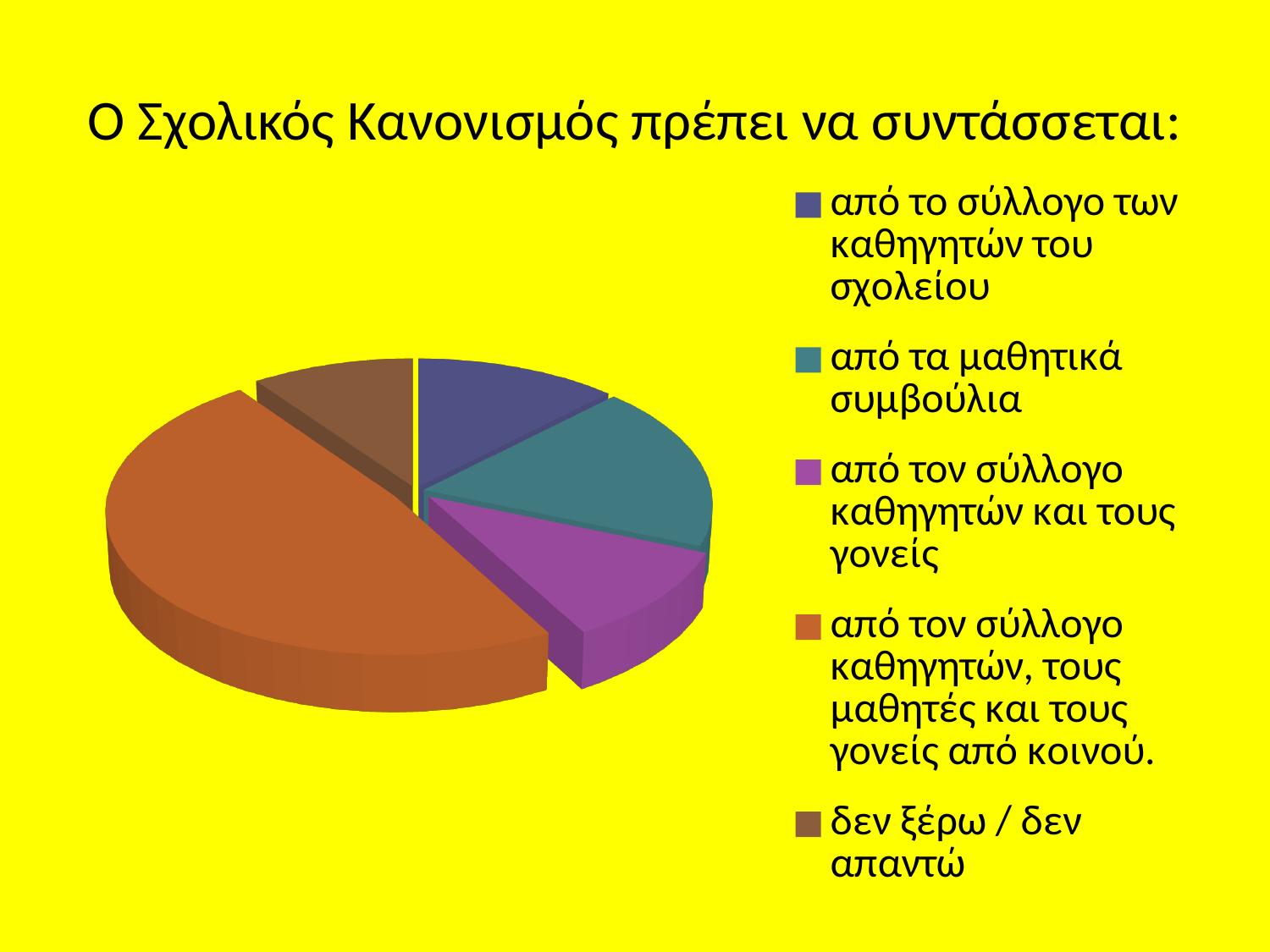
Which category has the largest slice of the pie? από τον σύλλογο καθηγητών, τους μαθητές και τους γονείς από κοινού. What colour is the slice for "από τα μαθητικά συμβούλια"? teal What is the title of the chart? Ο Σχολικός Κανονισμός πρέπει να συντάσσεται: What kind of chart is shown on the slide? pie chart Which slice is larger: "από τον σύλλογο καθηγητών, τους μαθητές και τους γονείς από κοινού." or "από τα μαθητικά συμβούλια"? από τον σύλλογο καθηγητών, τους μαθητές και τους γονείς από κοινού. How many entries does the legend list? 5 How many slices does the pie chart have? 5